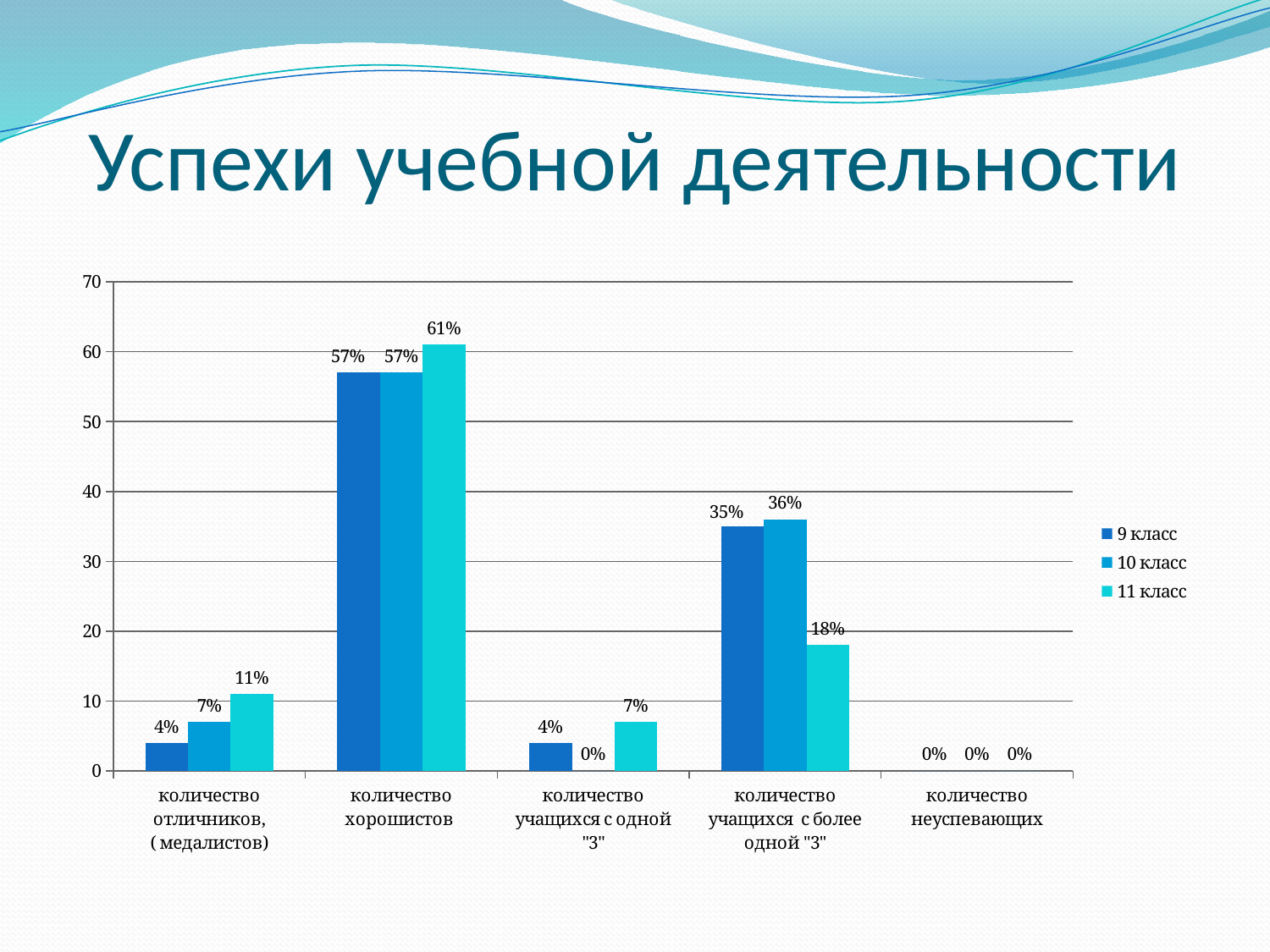
What is the value for 9 класс in the category количество хорошистов? 57% How many series does the legend list? 3 Which series has the lowest value in the category количество учащихся с более одной "3"? 11 класс What is the value for 10 класс in the category количество учащихся с одной "3"? 0% In the category количество отличников, (медалистов), which is larger: the value for 9 класс or for 11 класс? 11 класс What kind of chart is shown on the slide? bar chart What is the difference between the 10 класс and 11 класс values in the category количество учащихся с более одной "3"? 18% What is the value for 11 класс in the category количество учащихся с более одной "3"? 18% Is the value for 11 класс in the category количество хорошистов greater or less than 60? greater Which category has the highest value for 11 класс? количество хорошистов What is the value for 11 класс in the category количество отличников, (медалистов)? 11% How many categories are shown on the x axis? 5